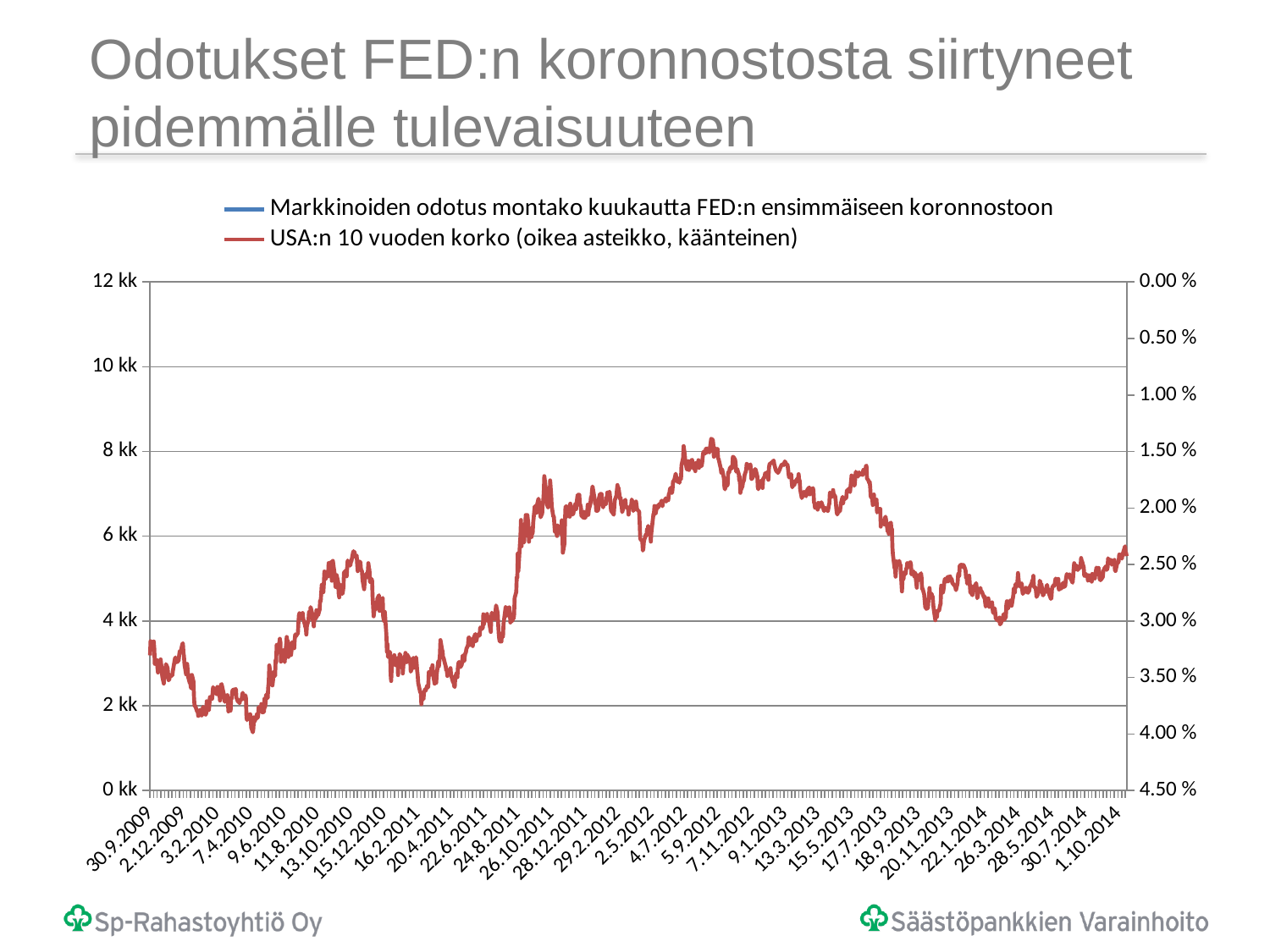
Around which x-axis label does the red line reach its highest point on the chart? 5.9.2012 Is the value of the red line (USA:n 10 vuoden korko, right axis) at 1.10.2014 greater or less than 3.00 %? less Around which x-axis label does the red line reach its lowest point on the chart? 7.4.2010 Is the value of the red line (USA:n 10 vuoden korko, right axis) around 5.9.2012 greater or less than 2.00 %? less Does the red line rise or fall on the chart between 26.3.2014 and 1.10.2014? rise Is the value of the red line (USA:n 10 vuoden korko, right axis) around 26.3.2014 greater or less than 2.50 %? greater What kind of chart is shown on the slide? line chart Does the red line rise or fall on the chart between 15.5.2013 and 18.9.2013? fall What is the highest tick label on the left vertical axis? 12 kk How many series does the legend list? 2